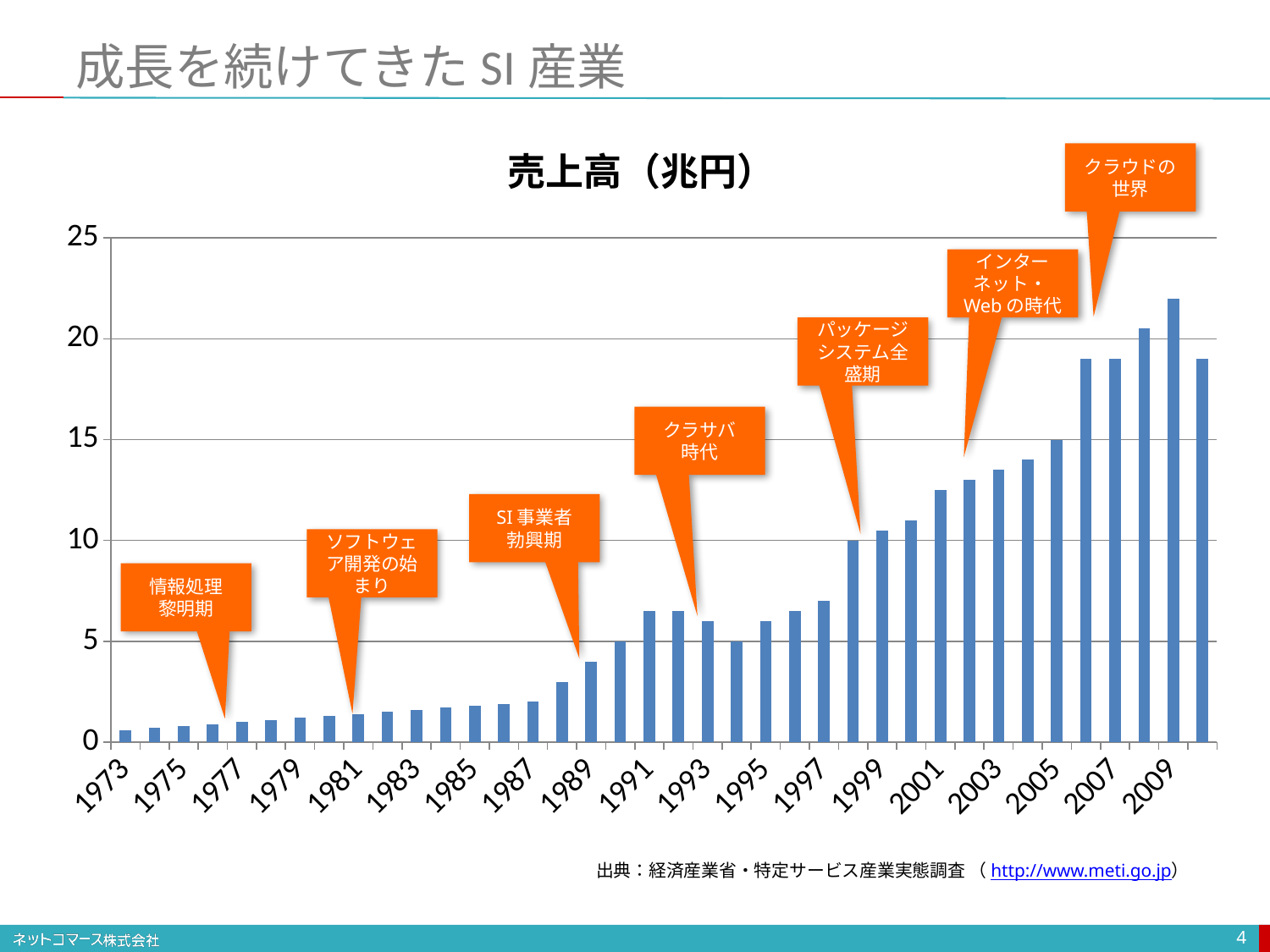
What is the title of the chart? 売上高（兆円） Is the value for 1981 greater or less than 5? less Do the values generally rise or fall from 1973 to 2009? rise Is the value for 2007 greater or less than 15? greater Is the value for 2009 greater or less than 20? greater Which year has the lowest bar in the chart? 1973 What kind of chart is shown on the slide? bar chart Which is larger, the value for 2009 or the value for 2010? 2009 Which is larger, the value for 1997 or the value for 1989? 1997 Which year has the highest bar in the chart? 2009